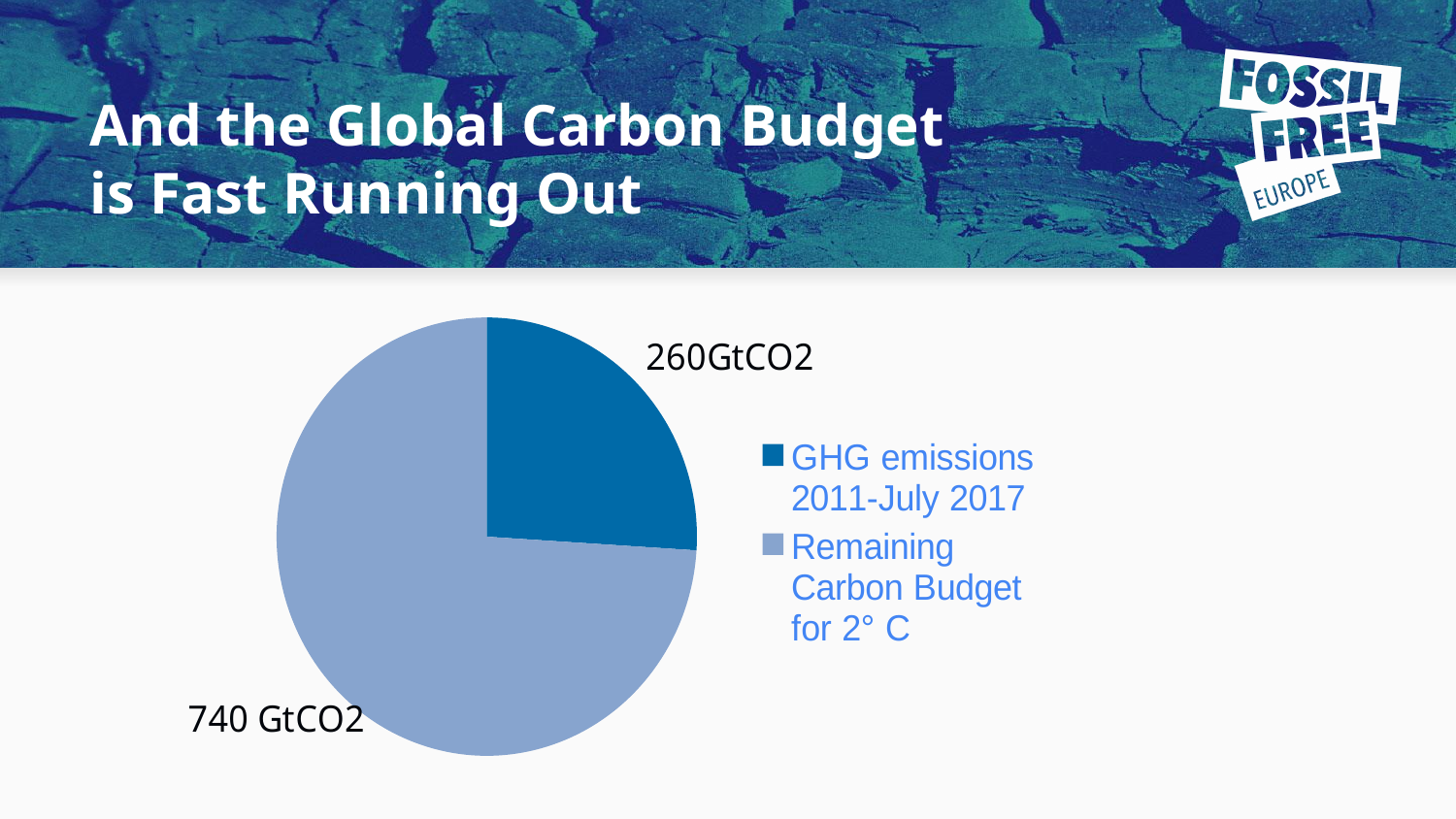
How many entries does the legend list? 2 What is the difference between the Remaining Carbon Budget for 2° C and GHG emissions 2011-July 2017? 480 GtCO2 What is the value for Remaining Carbon Budget for 2° C? 740 GtCO2 What is the total of the two slices in the pie chart? 1000 GtCO2 What share of the pie does GHG emissions 2011-July 2017 represent? 26% Which is larger: GHG emissions 2011-July 2017 or Remaining Carbon Budget for 2° C? Remaining Carbon Budget for 2° C How many slices does the pie chart have? 2 What is the value for GHG emissions 2011-July 2017? 260GtCO2 What kind of chart is shown on the slide? pie chart Which slice of the pie is the largest? Remaining Carbon Budget for 2° C Which slice of the pie is the smallest? GHG emissions 2011-July 2017 What is the title of the slide containing the pie chart? And the Global Carbon Budget is Fast Running Out